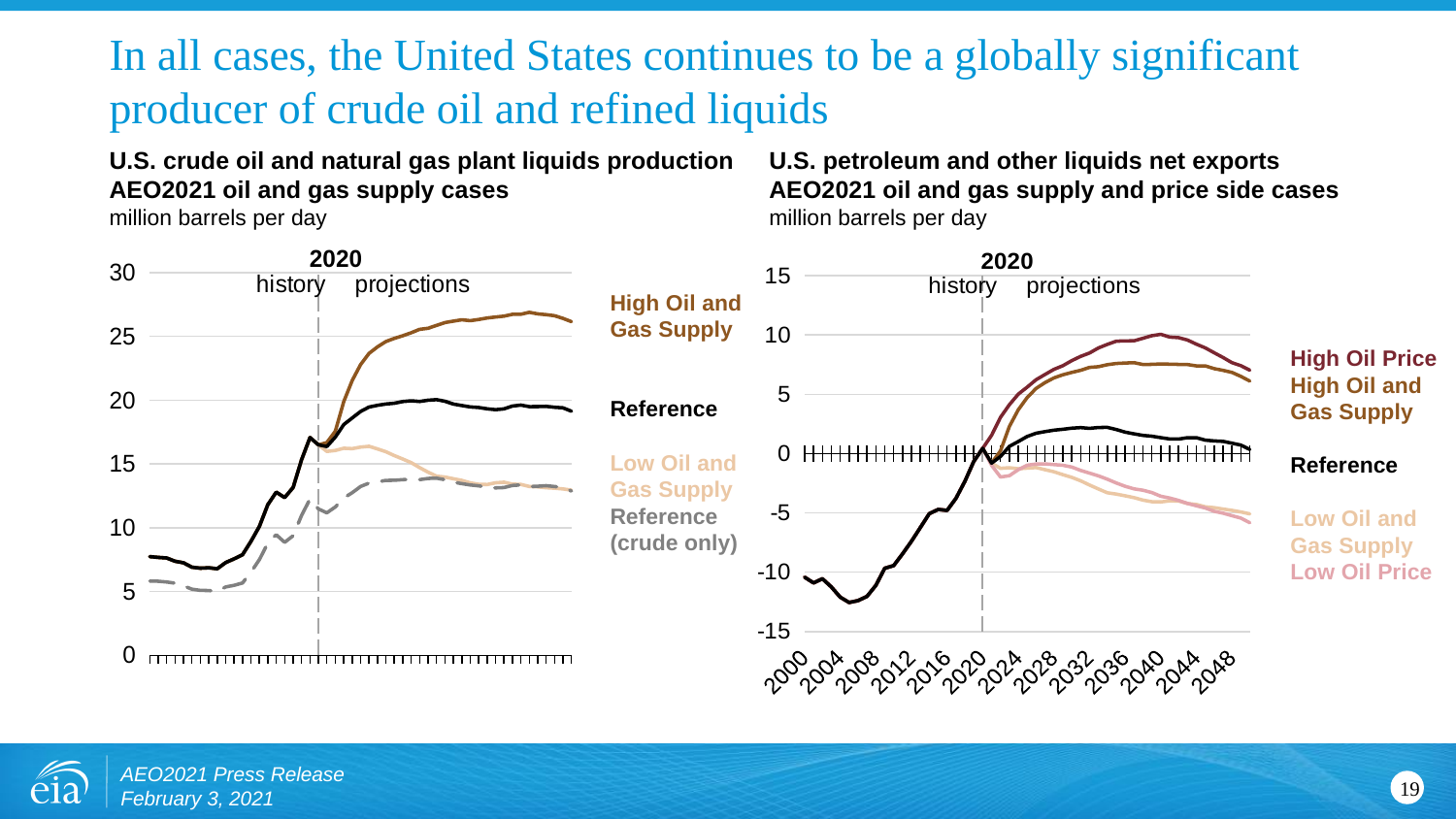
On the left chart, is the Reference value at the end of the projection period greater or less than 20? less What unit is used on both charts? million barrels per day On the right chart, is the net exports value in 2008 greater or less than -10? less On the right chart, is the High Oil and Gas Supply value in 2048 greater or less than 5? greater On the right chart, which series is lowest at the end of the projection period? Low Oil Price On the right chart, which series is highest in 2040: High Oil Price or High Oil and Gas Supply? High Oil Price How many series are labelled on the right chart, 'U.S. petroleum and other liquids net exports'? 5 How many series are labelled on the left chart, 'U.S. crude oil and natural gas plant liquids production'? 4 What type of chart is the left chart, 'U.S. crude oil and natural gas plant liquids production'? line chart On the right chart, do net exports rise or fall between 2008 and 2020? rise